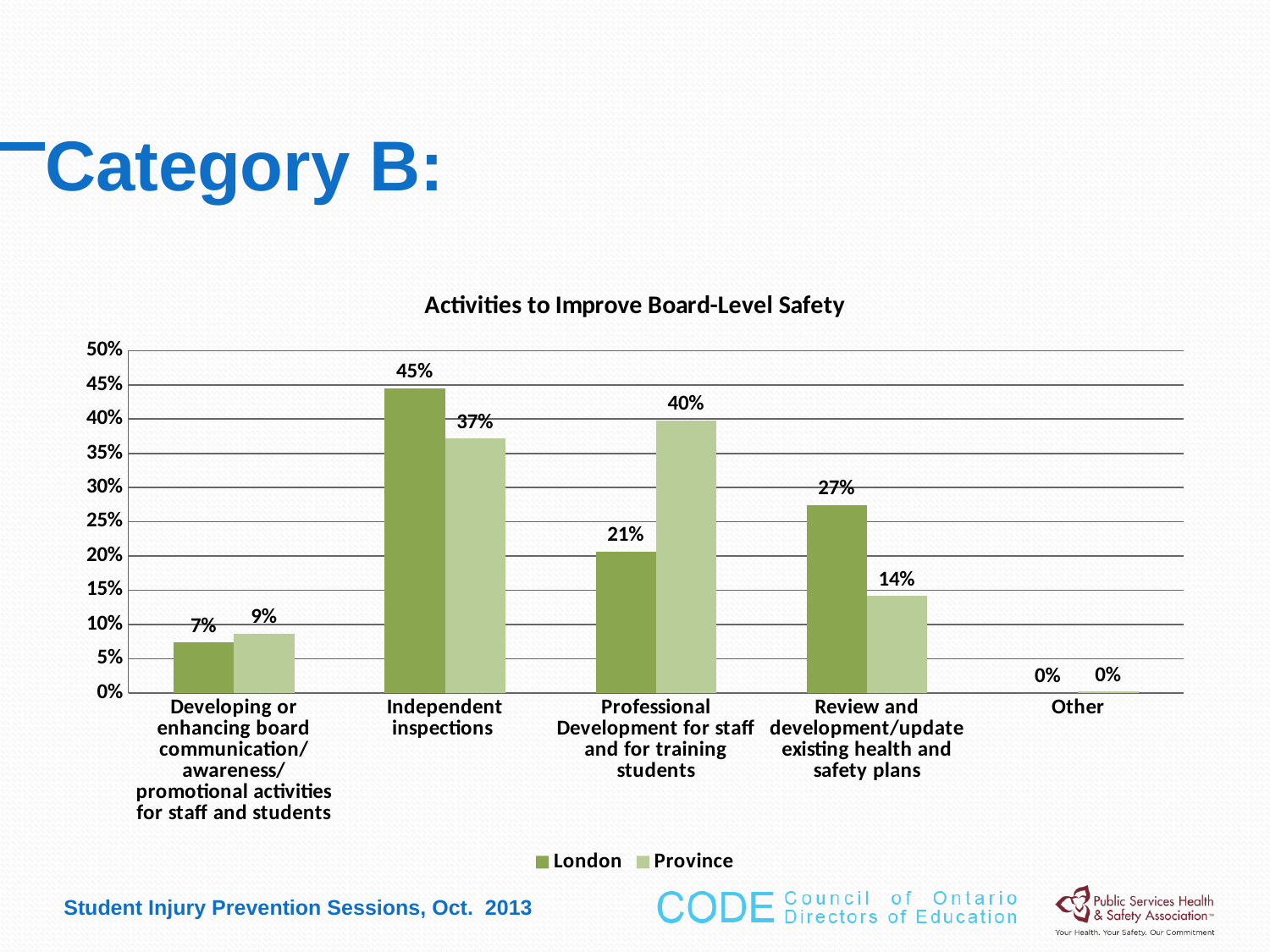
What is the difference between the London and Province values for Independent inspections? 8% For Professional Development for staff and for training students, which is larger, London or Province? Province How many series does the legend list? 2 How many categories are shown on the x axis? 5 What is the title of the chart? Activities to Improve Board-Level Safety What kind of chart is shown? Bar chart What is the difference between the London and Province values for Review and development/update existing health and safety plans? 13% What is the Province value for Review and development/update existing health and safety plans? 14% What is the Province value for Professional Development for staff and for training students? 40% Which category has the lowest Province value? Other Which category has the highest London value? Independent inspections What is the London value for Independent inspections? 45%